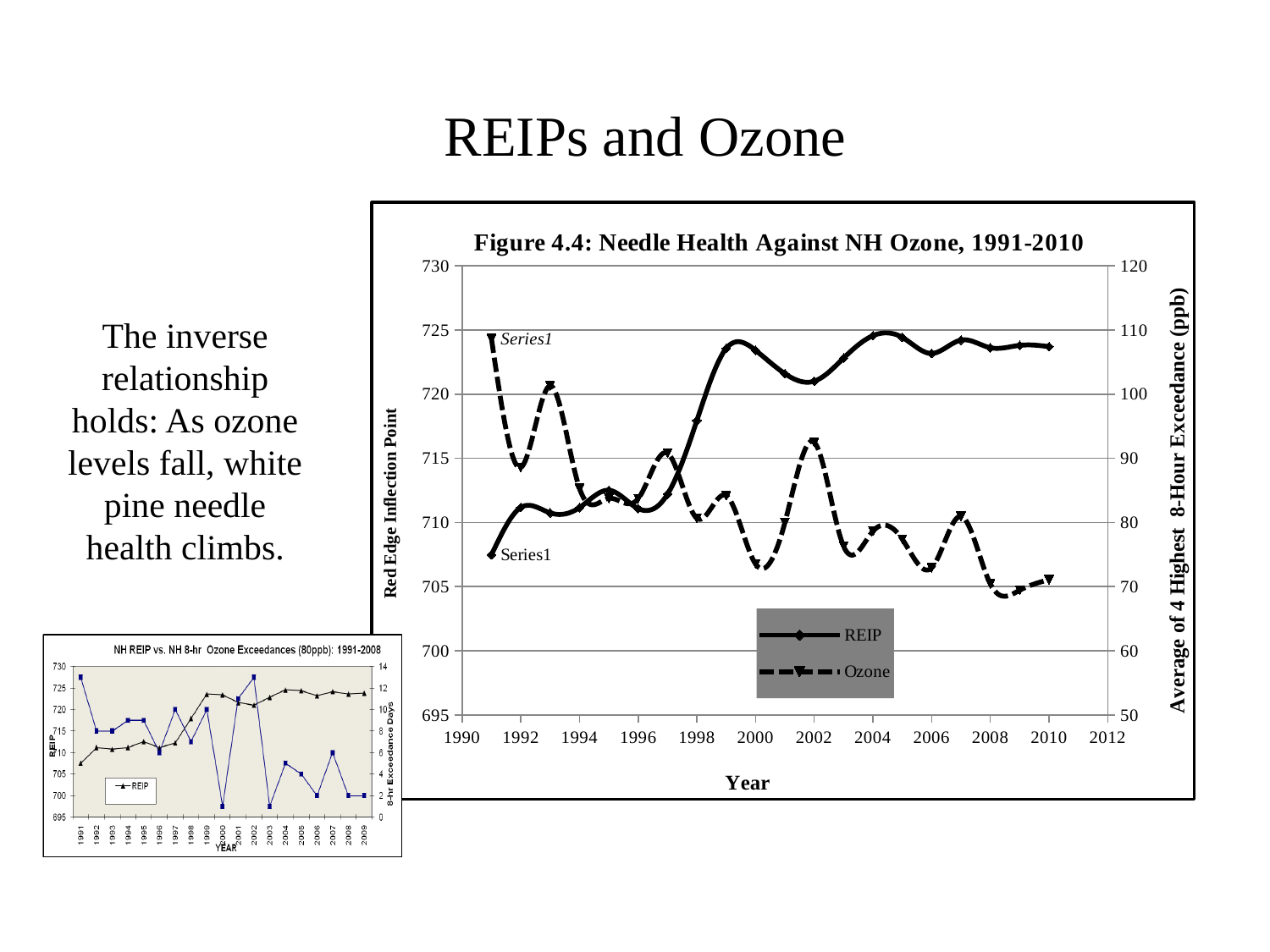
In the main chart (Figure 4.4), what is the label of the left vertical axis? Red Edge Inflection Point In the main chart (Figure 4.4), does the REIP series generally rise or fall from 1991 to 2010? Rise In the main chart (Figure 4.4), what are the two series named in the legend? REIP and Ozone In the main chart (Figure 4.4), how many series does the legend list? 2 In the main chart (Figure 4.4), is the REIP value for 2004 greater or less than 720? greater In the main chart (Figure 4.4), which year has the larger Ozone value, 1991 or 2010? 1991 In the main chart (Figure 4.4), is the Ozone value for 2010 greater or less than 80? less In the main chart (Figure 4.4), is the Ozone value for 1991 greater or less than 100? greater What type of chart is the main chart titled "Figure 4.4: Needle Health Against NH Ozone, 1991-2010"? Line chart In the main chart (Figure 4.4), which year has the larger REIP value, 1991 or 2004? 2004 In the main chart (Figure 4.4), does the Ozone series generally rise or fall from 1991 to 2010? Fall